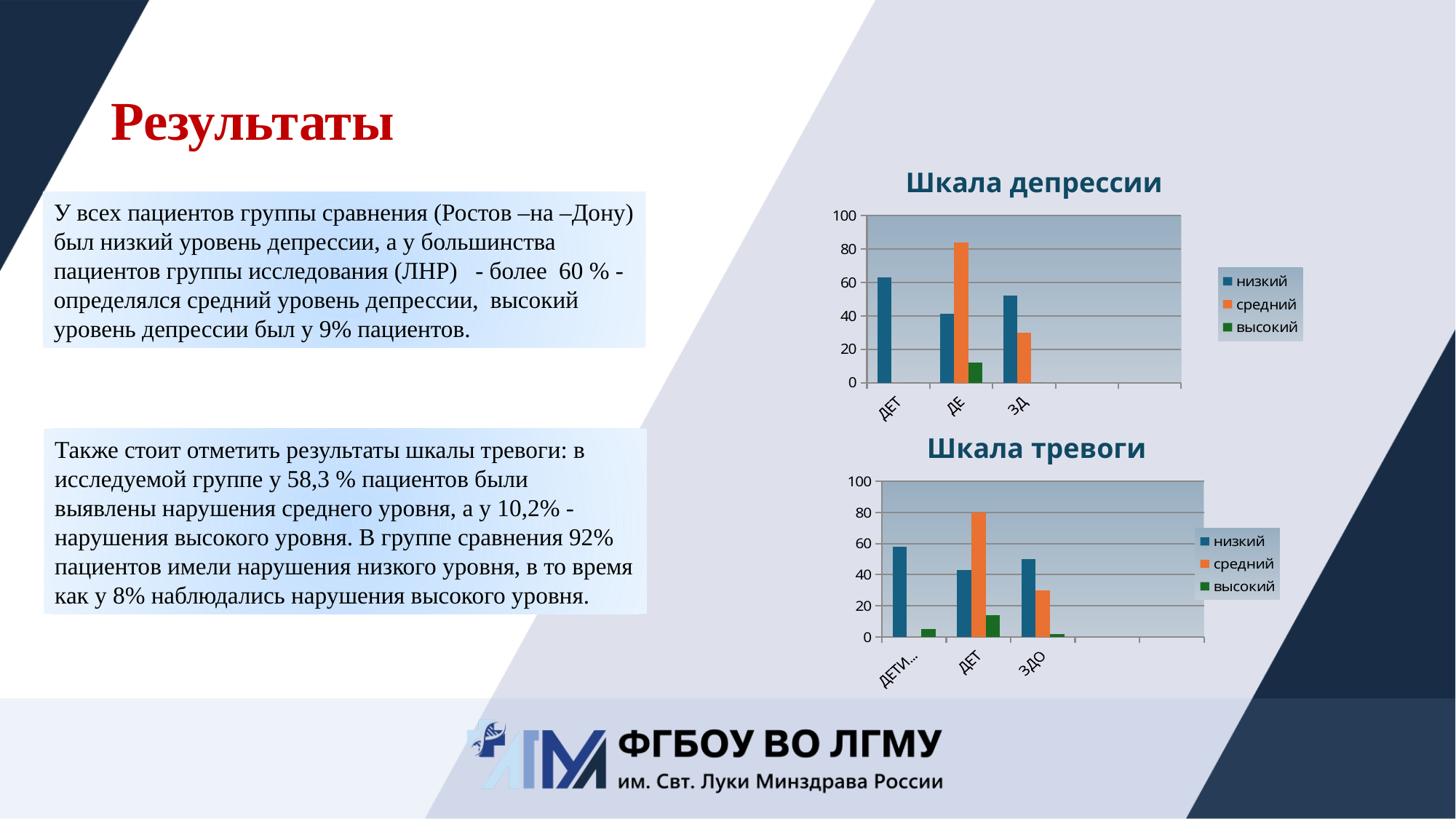
In the 'Шкала депрессии' chart, is the 'низкий' value for ДЕТ greater or less than 60? greater How many series does the legend of the 'Шкала тревоги' chart list? 3 In the 'Шкала тревоги' chart, which is larger for category ЗДО: the 'низкий' value or the 'средний' value? низкий How many categories are shown on the x axis of the 'Шкала депрессии' chart? 3 In the 'Шкала депрессии' chart, which series has the tallest bar for category ДЕ? средний In the 'Шкала тревоги' chart, is the 'средний' value for ДЕТ greater or less than 60? greater In the 'Шкала тревоги' chart, is the 'высокий' value for ЗДО greater or less than 20? less What is the title of the lower chart on the slide? Шкала тревоги What kind of chart is the 'Шкала депрессии' chart? bar chart In the 'Шкала тревоги' chart, which series has the tallest bar for category ДЕТ? средний